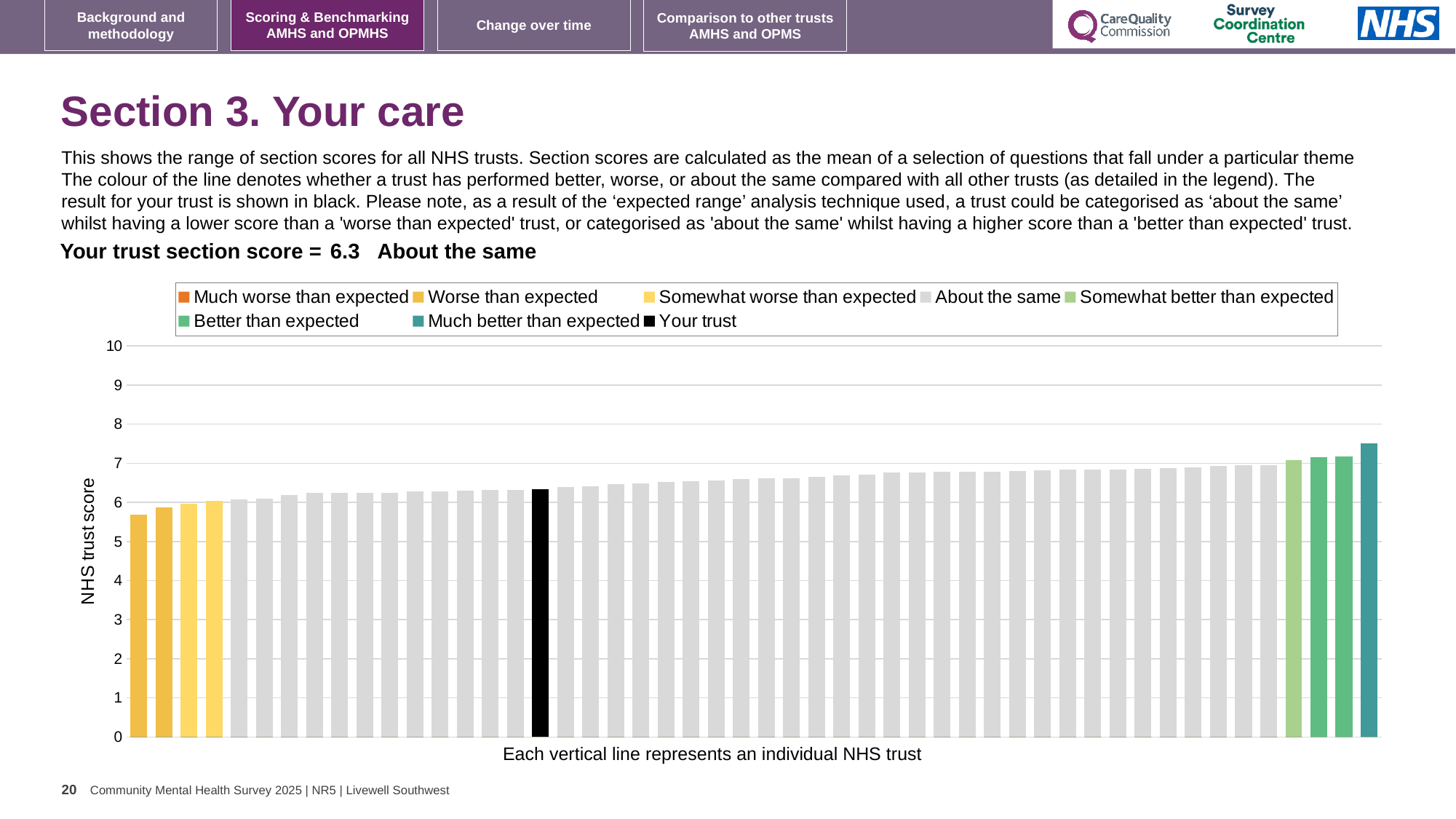
What colour is used for the 'Your trust' bar in the chart? black Is the value of the black bar (your trust) greater or less than 6? greater What is the label on the vertical axis of the chart? NHS trust score Which category is your trust placed in for this section? About the same Is the value of the rightmost bar greater or less than 7? greater What is the highest tick value shown on the vertical axis? 10 What is the section score for your trust shown on the slide? 6.3 Is the value of the leftmost bar greater or less than 6? less How many entries does the chart legend list? 8 Do the bar values rise or fall from left to right along the x axis? rise What kind of chart is shown on the slide? bar chart